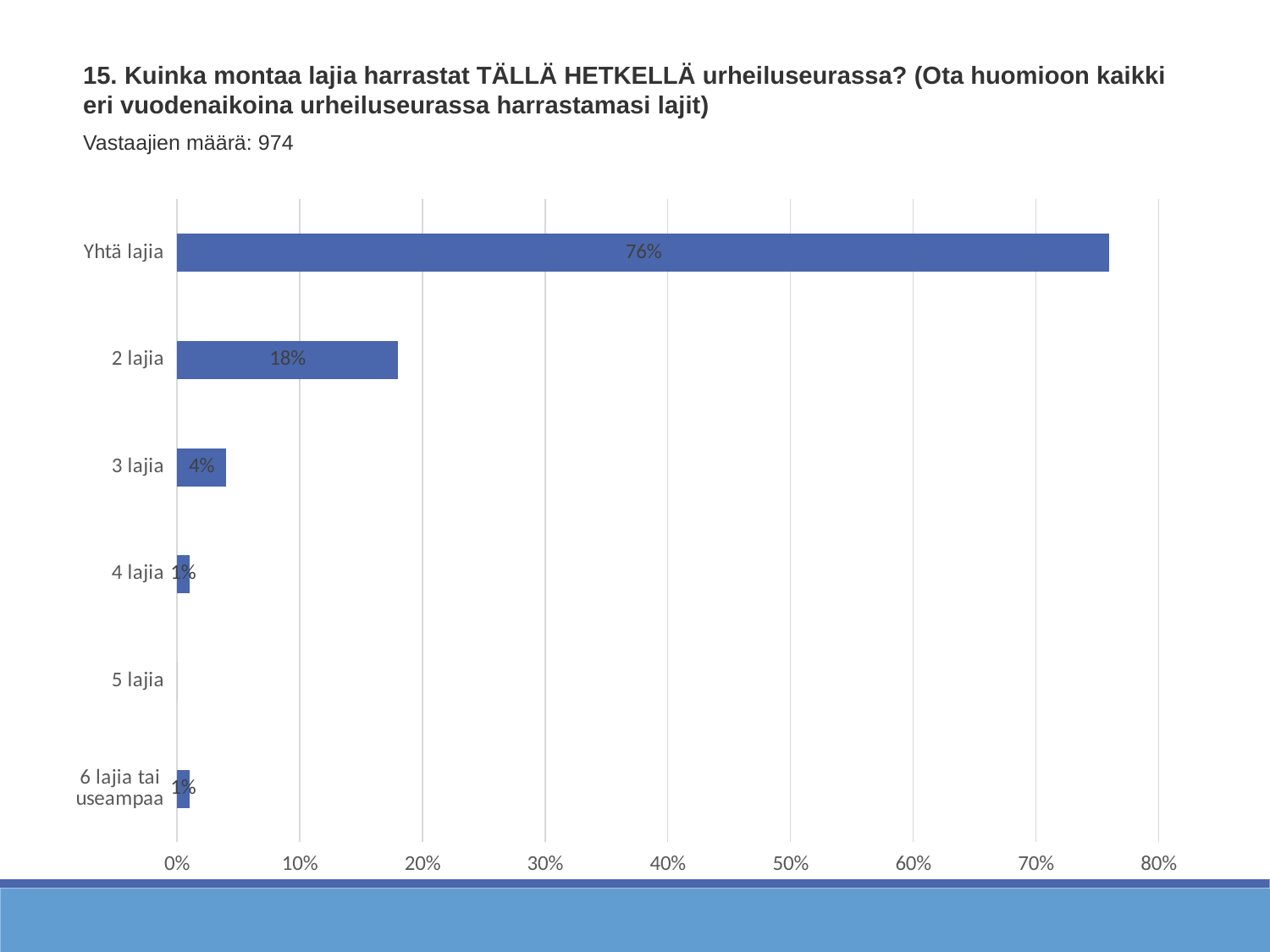
How many categories are shown on the chart? 6 Which is larger, the value for "2 lajia" or the value for "3 lajia"? 2 lajia Is the value for "Yhtä lajia" greater or less than 70%? greater What is the difference between the values for "Yhtä lajia" and "2 lajia"? 58% What is the value for "6 lajia tai useampaa"? 1% What is the value for "Yhtä lajia"? 76% Which category has the highest value? Yhtä lajia What is the value for "4 lajia"? 1% What is the difference between the values for "2 lajia" and "3 lajia"? 14% What is the value for "2 lajia"? 18% What is the value for "3 lajia"? 4% What kind of chart is shown on the slide? bar chart